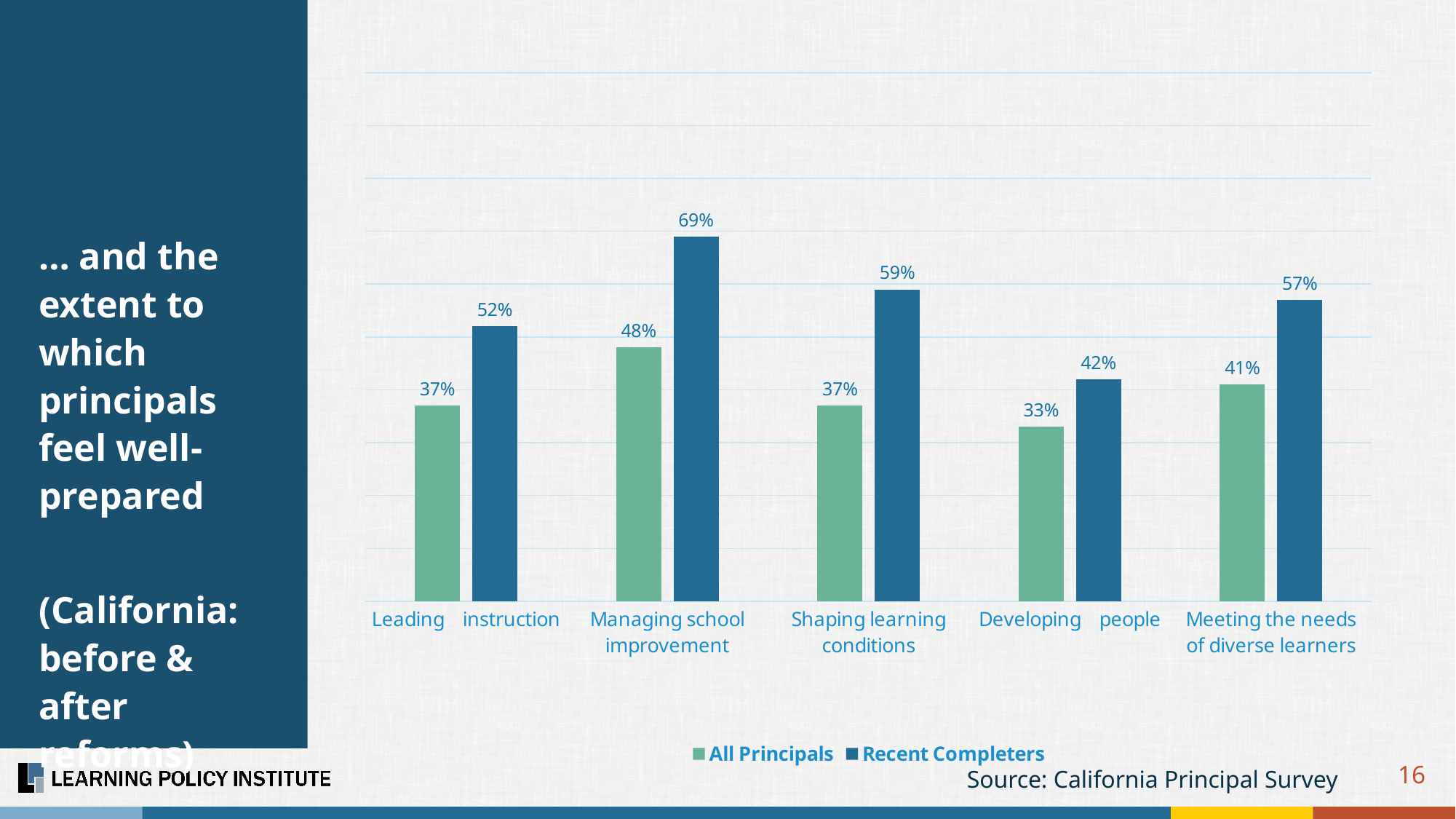
Which category has the highest value for Recent Completers? Managing school improvement What is the value for All Principals in the Meeting the needs of diverse learners category? 41% What kind of chart is shown on the slide? Bar chart How many series does the legend list? 2 Which is larger in the Leading instruction category: All Principals or Recent Completers? Recent Completers What is the value for Recent Completers in the Developing people category? 42% What is the value for All Principals in the Developing people category? 33% How many categories are shown on the x axis? 5 What is the value for Recent Completers in the Managing school improvement category? 69% Which category has the lowest value for All Principals? Developing people What is the difference between Recent Completers and All Principals in the Shaping learning conditions category? 22% Which series is shown in green in the legend? All Principals